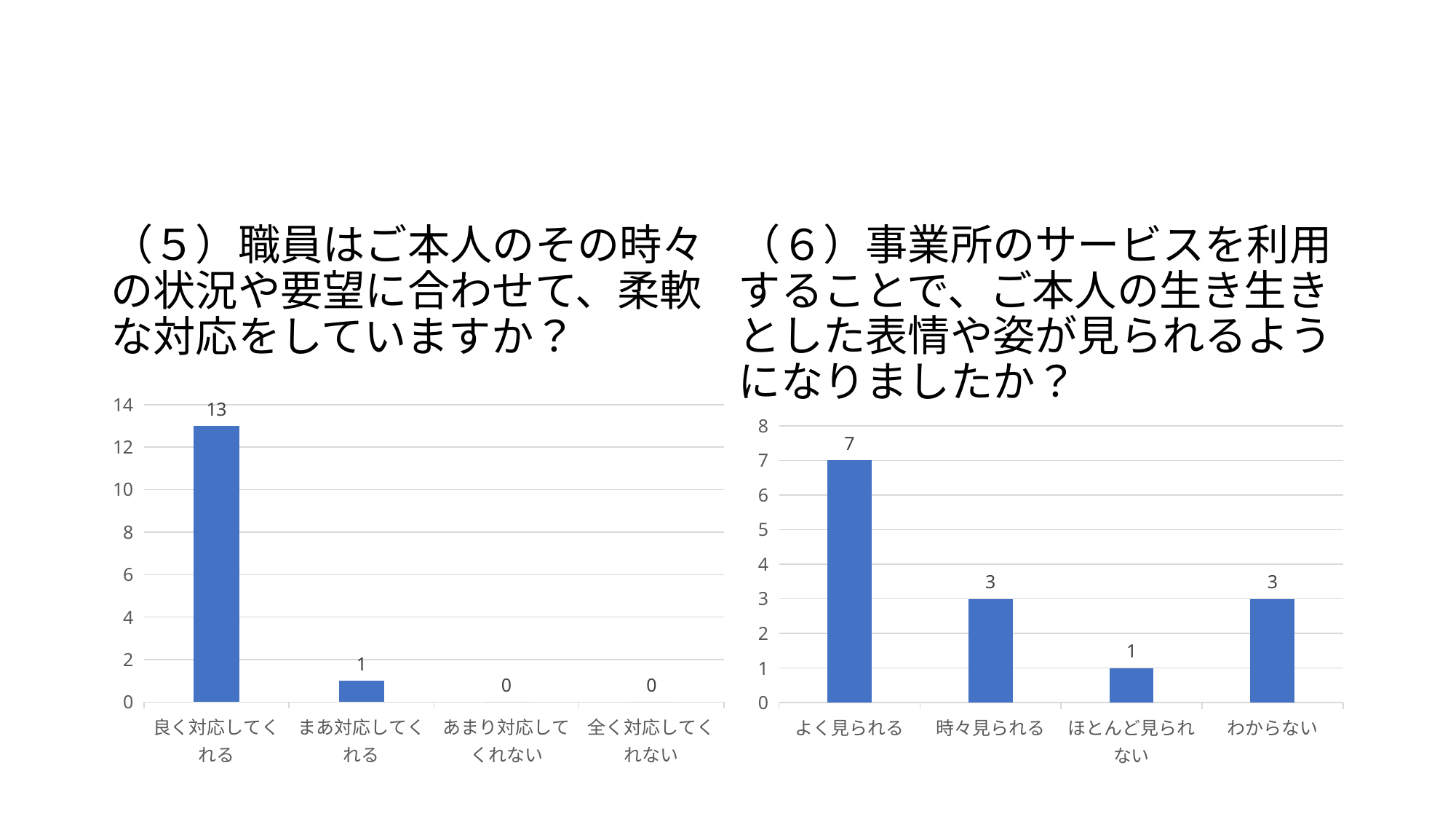
In the left chart (５), what is the difference between 良く対応してくれる and まあ対応してくれる? 12 In the right chart (６), what is the difference between よく見られる and 時々見られる? 4 In the left chart (５), what is the value for 全く対応してくれない? 0 In the right chart (６), which category has the lowest value? ほとんど見られない What kind of chart is the right chart (６)? bar chart In the right chart (６), what is the value for よく見られる? 7 In the left chart (５), what is the value for 良く対応してくれる? 13 In the left chart (５), how many categories are shown on the x axis? 4 In the left chart (５), what is the value for まあ対応してくれる? 1 In the right chart (６), which is larger, よく見られる or わからない? よく見られる In the right chart (６), what is the value for ほとんど見られない? 1 In the left chart (５), which category has the highest value? 良く対応してくれる